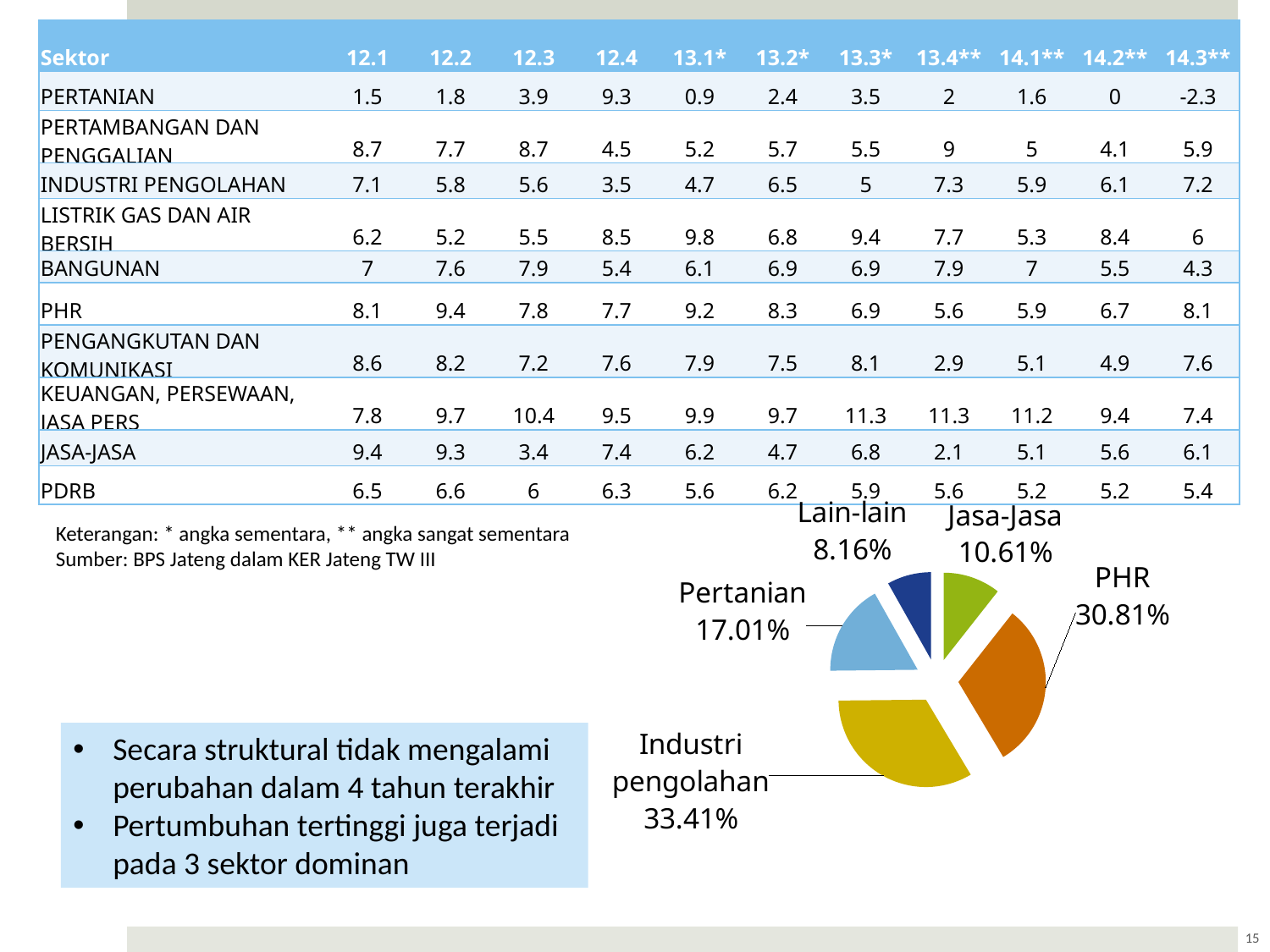
In the pie chart, what is the difference between the shares of Pertanian and Lain-lain? 8.85% In the pie chart, which is larger: the share of Pertanian or the share of Jasa-Jasa? Pertanian Which slice of the pie chart is the largest? Industri pengolahan What share of the pie chart does Lain-lain hold? 8.16% Which slice of the pie chart is the smallest? Lain-lain How many slices does the pie chart have? 5 What share of the pie chart does Industri pengolahan hold? 33.41% What share of the pie chart does Jasa-Jasa hold? 10.61% In the pie chart, what is the difference between the shares of Industri pengolahan and PHR? 2.60% What kind of chart is shown on the slide? pie chart